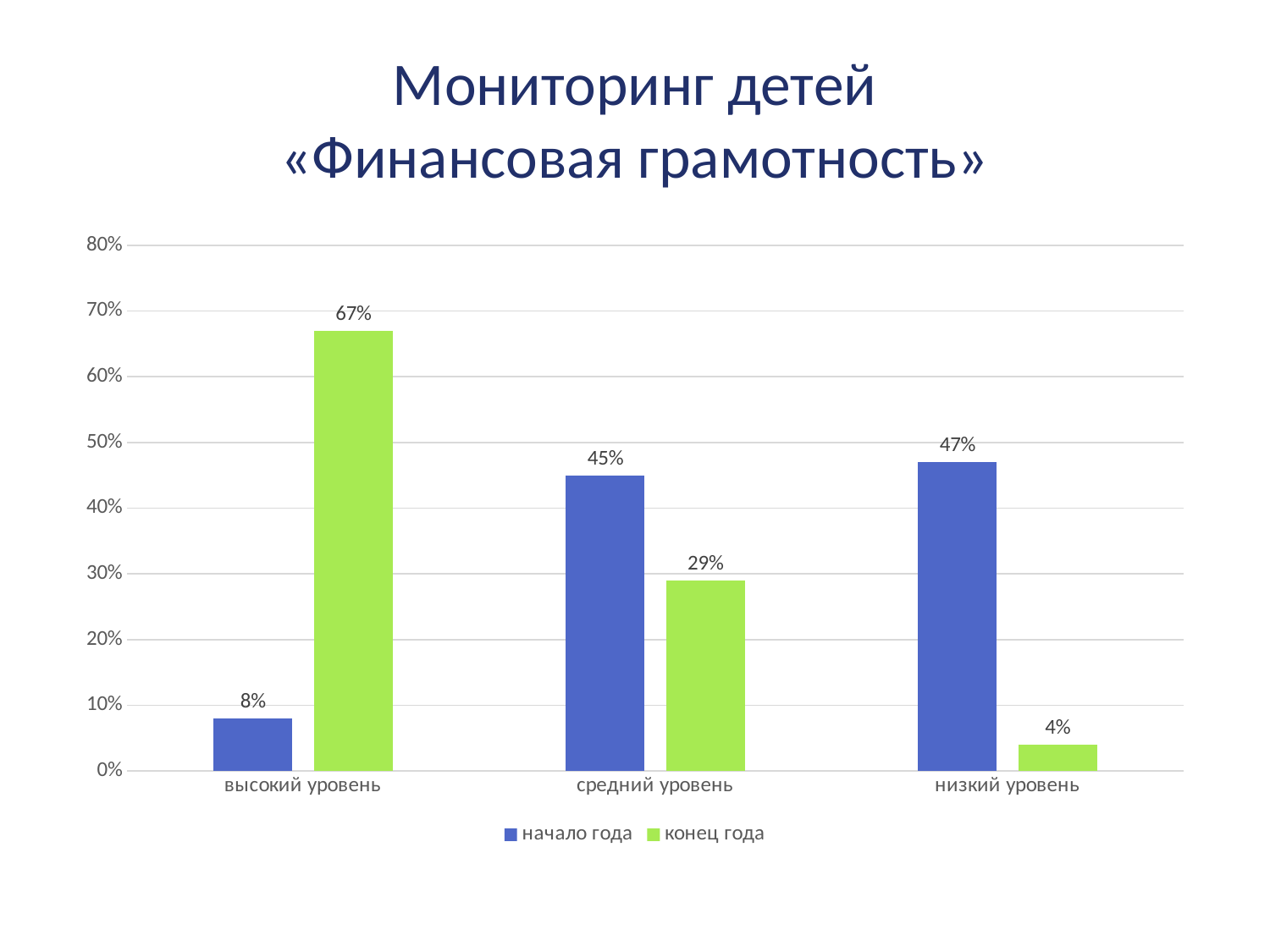
What is the value for «высокий уровень» in the «конец года» series? 67% Which category has the lowest value in the «конец года» series? низкий уровень What is the difference between the «начало года» and «конец года» values for «средний уровень»? 16% What is the difference between the «конец года» and «начало года» values for «высокий уровень»? 59% What is the value for «средний уровень» in the «начало года» series? 45% What is the value for «высокий уровень» in the «начало года» series? 8% What is the value for «низкий уровень» in the «конец года» series? 4% How many categories are shown on the x axis? 3 Which category has the highest value in the «начало года» series? низкий уровень How many series does the legend list? 2 What kind of chart is shown on the slide? bar chart Which is larger for «низкий уровень»: the «начало года» value or the «конец года» value? начало года